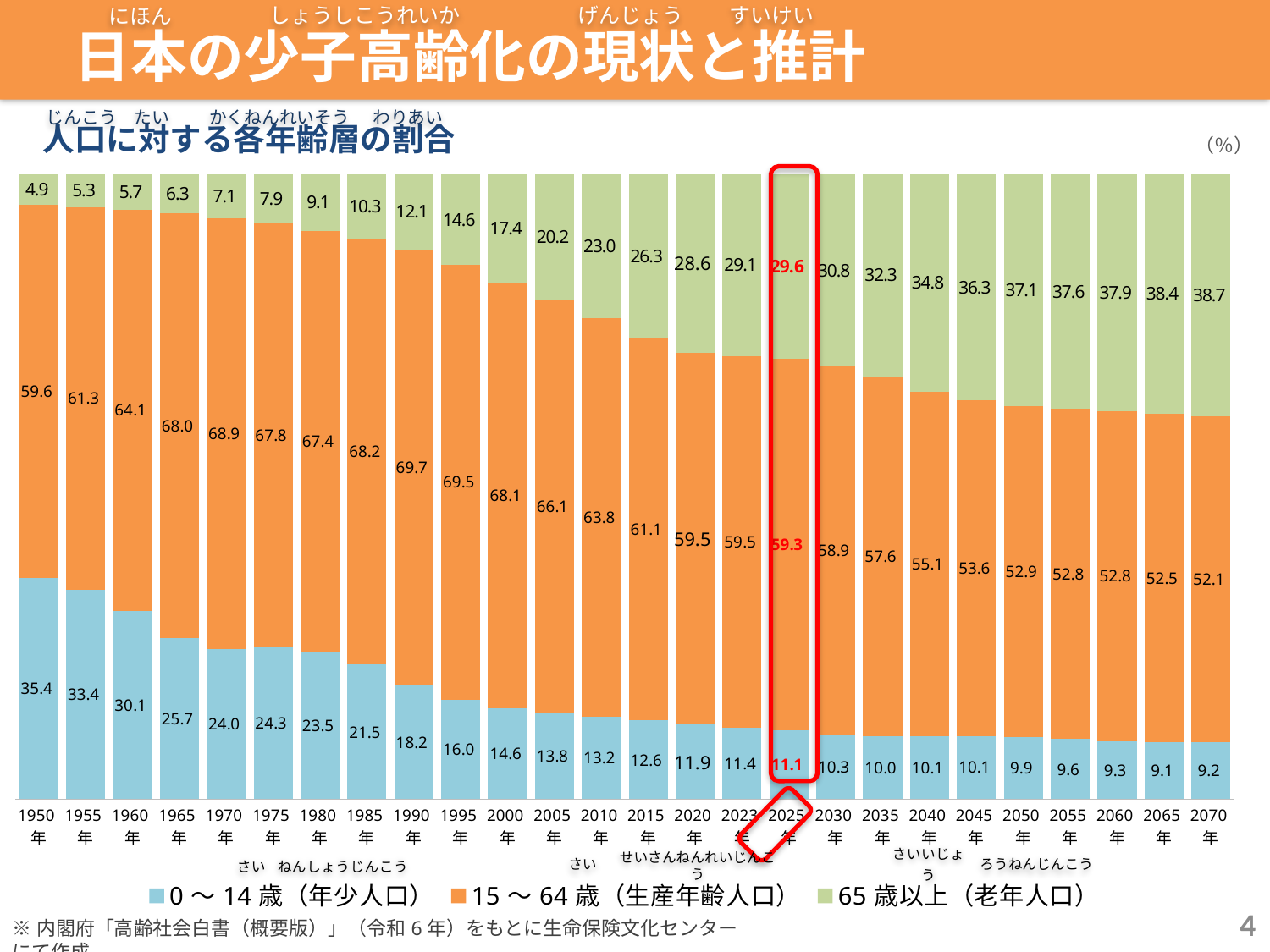
In which year is the 0～14歳（年少人口） share lowest? 2065年 In which year is the 65歳以上（老年人口） share highest? 2070年 Which is larger, the 15～64歳（生産年齢人口） value in 1990年 or in 2020年? 1990年 What is the value for 0～14歳（年少人口） in 1950年? 35.4 Which year is highlighted with a red box on the chart? 2025年 What is the difference between the 65歳以上（老年人口） values for 2070年 and 1950年? 33.8 What type of chart is shown on the slide? stacked bar chart How many series does the legend list? 3 How many years (categories) are shown along the x axis? 26 What is the value for 15～64歳（生産年齢人口） in 2070年? 52.1 How does the 0～14歳（年少人口） share change from 1950年 to 2070年? falls What is the value for 65歳以上（老年人口） in 2025年? 29.6